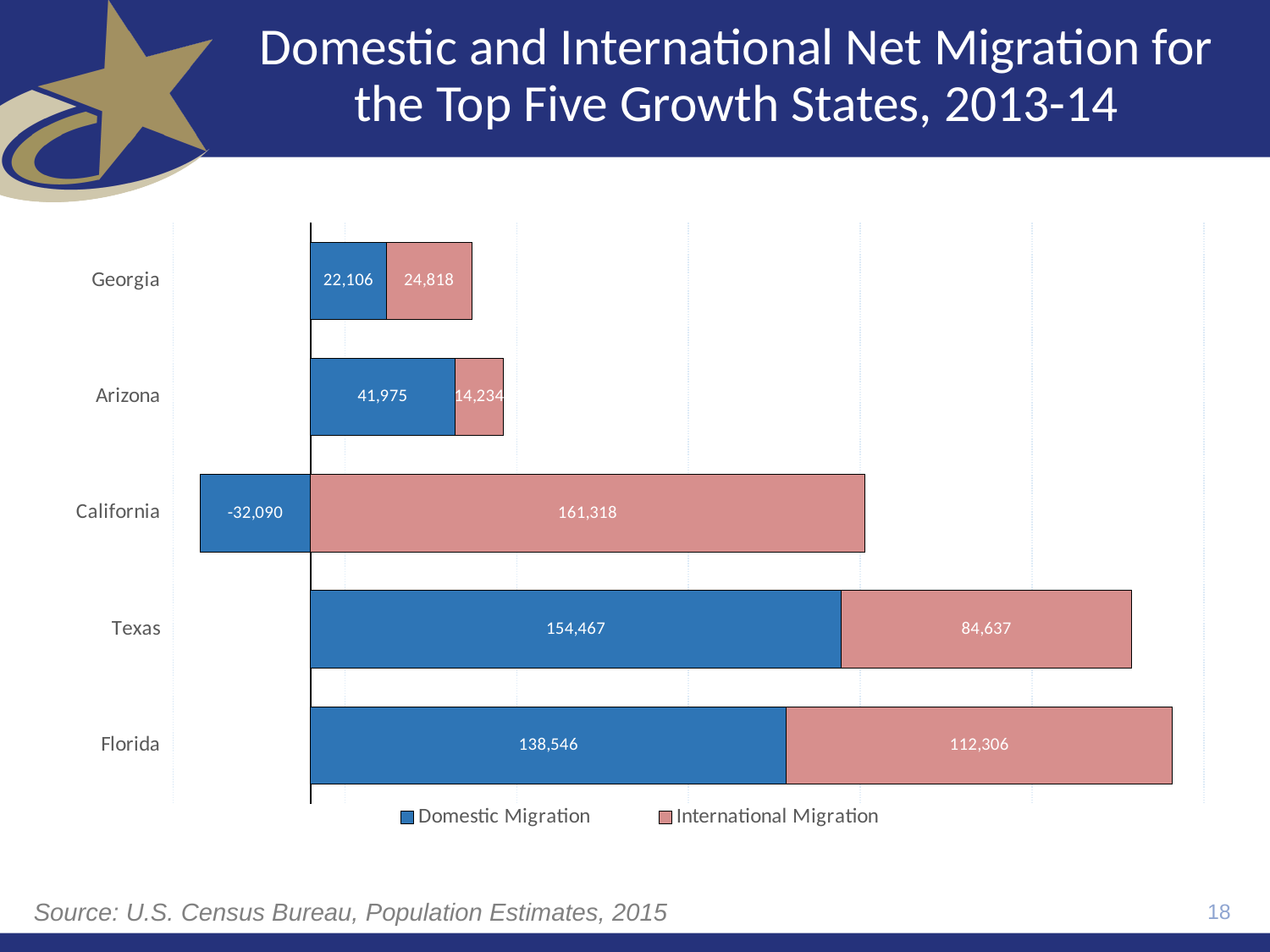
How many states are shown in the chart? 5 Which state has the highest Domestic Migration value? Texas What is the difference between the Domestic Migration values for Texas and Florida? 15,921 What is the International Migration value for Arizona? 14,234 What kind of chart is shown on the slide? Stacked bar chart What is the total of Domestic Migration and International Migration for Florida? 250,852 How many series does the legend list? 2 Which is larger, the International Migration value for Florida or for Texas? Florida What is the Domestic Migration value for Texas? 154,467 What is the International Migration value for California? 161,318 Which state has the lowest International Migration value? Arizona What is the Domestic Migration value for California? -32,090